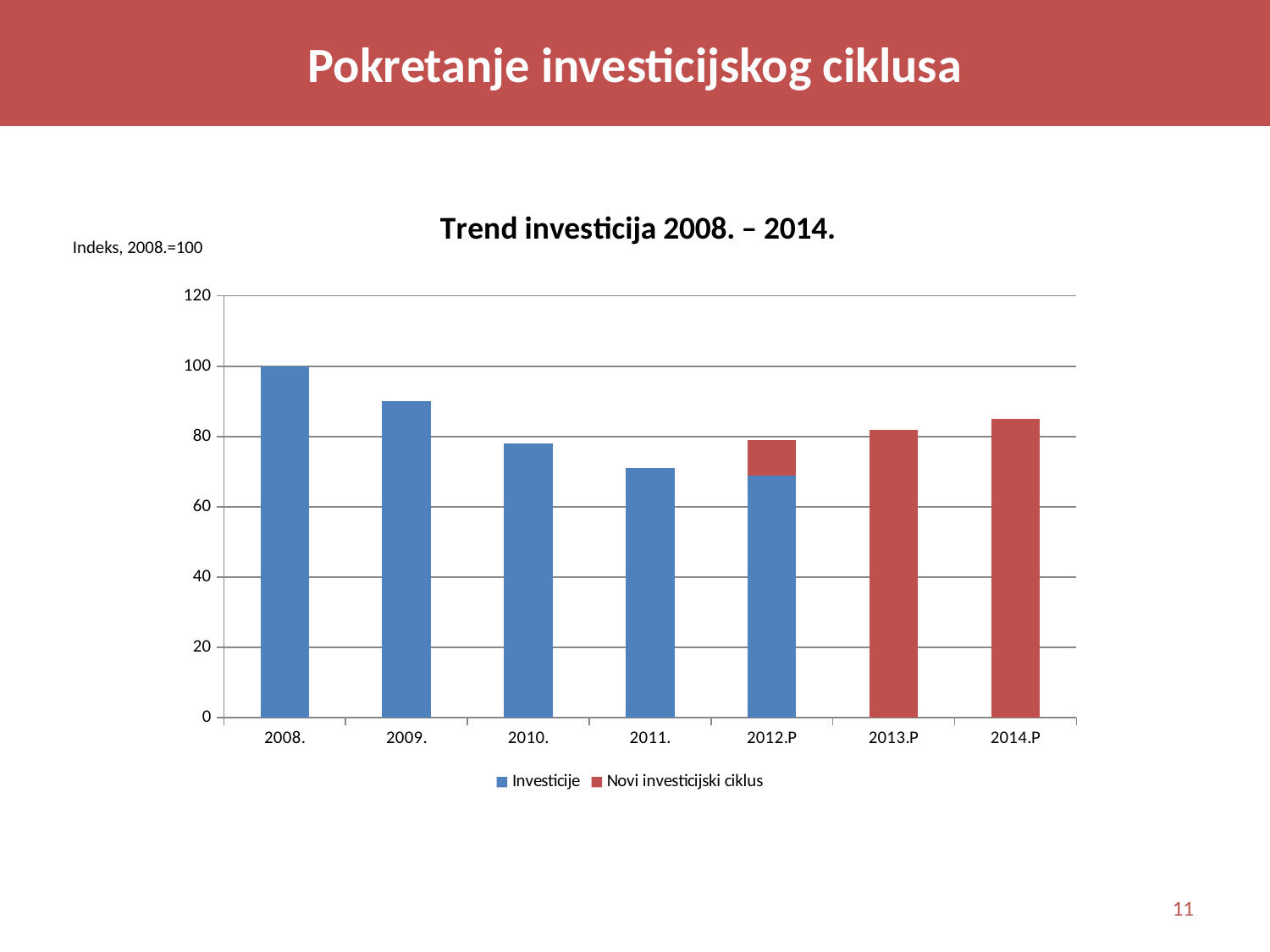
How many series does the legend list? 2 Is the value for 2009. greater or less than 80? greater Do the Investicije values rise or fall from 2008. to 2011.? fall How many year categories are shown on the x axis? 7 Which year has the shortest bar overall? 2011. What type of chart is shown on the slide? bar chart Is the value for 2010. greater or less than 80? less What is the value of the Investicije bar for 2008.? 100 Is the Investicije value for 2012.P greater or less than 80? less What is the title of the chart? Trend investicija 2008. – 2014. Which is larger, the bar for 2009. or the bar for 2010.? 2009. Which year has the tallest bar? 2008.